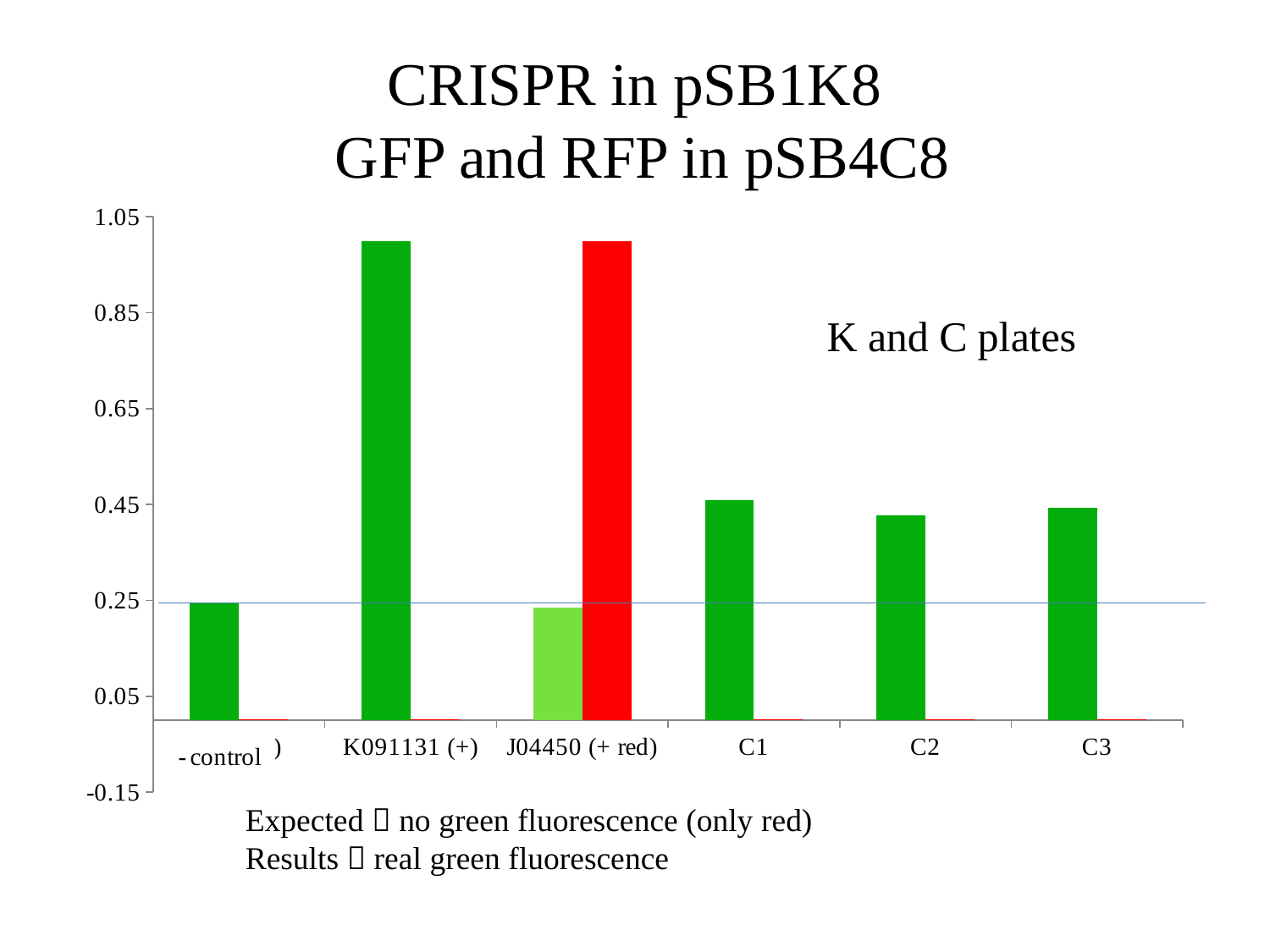
What kind of chart is shown on the slide? bar chart Is the green bar for - control greater or less than 0.45? less Which is larger, the green bar for K091131 (+) or the green bar for C1? K091131 (+) Is the red bar for J04450 (+ red) greater or less than 0.85? greater Is the green bar for C1 greater or less than 0.25? greater What is the title of the chart on the slide? CRISPR in pSB1K8 GFP and RFP in pSB4C8 How many categories are shown along the x axis of the chart? 6 Which category has the tallest green bar? K091131 (+) Which is larger, the green bar for - control or the green bar for C2? C2 Which is larger, the red bar for J04450 (+ red) or the red bar for C1? J04450 (+ red)